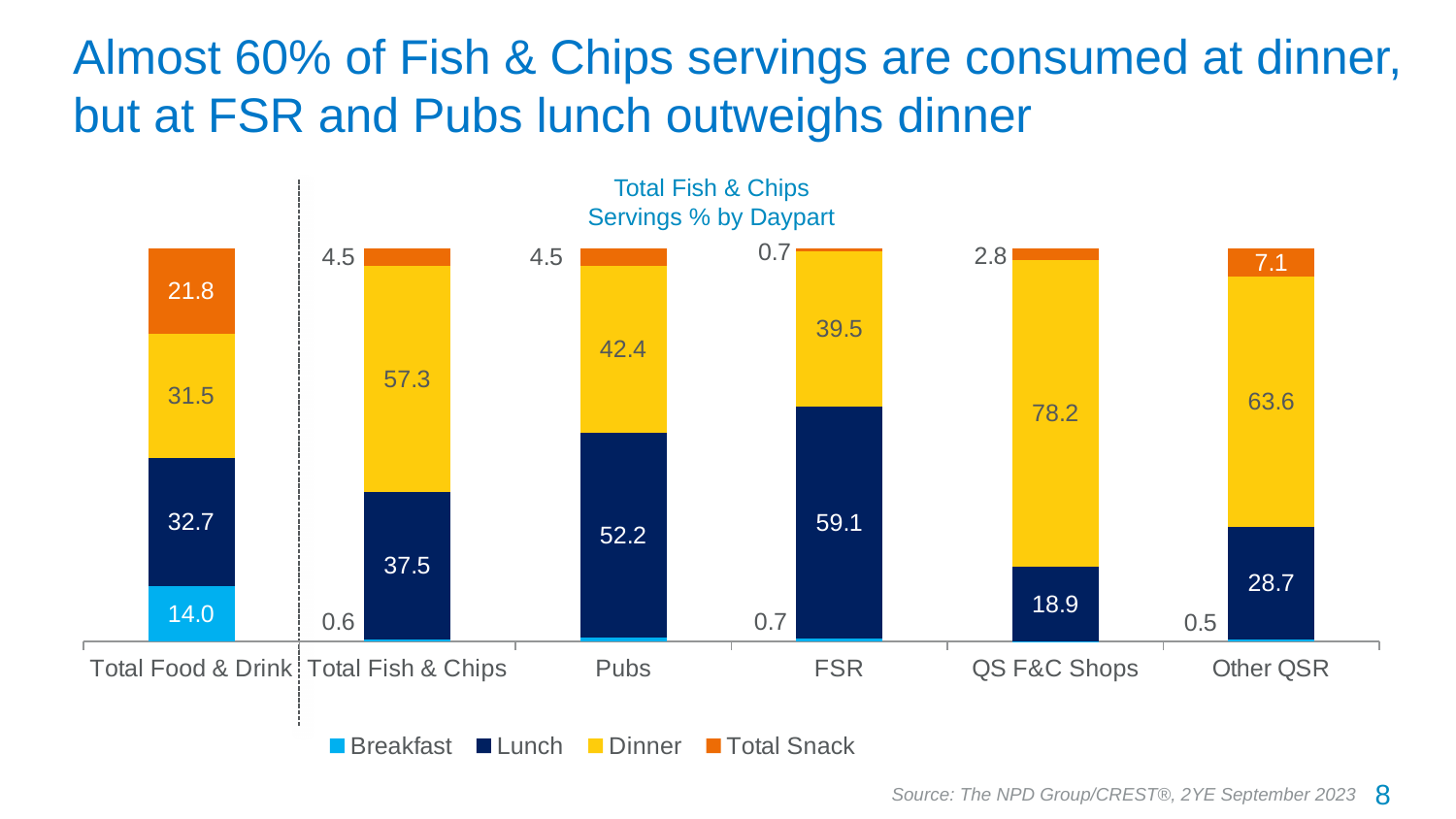
What is the Dinner value for QS F&C Shops? 78.2 Which category has the highest Dinner value? QS F&C Shops How many categories are shown on the x axis? 6 How many series does the legend list? 4 What is the Breakfast value for Total Food & Drink? 14.0 For Pubs, which is larger: the Lunch value or the Dinner value? Lunch For Total Fish & Chips, how much larger is the Dinner value than the Lunch value? 19.8 What is the Total Snack value for Other QSR? 7.1 Which category has the lowest Lunch value? QS F&C Shops What is the total of the stacked bar for Total Food & Drink? 100.0 What is the Lunch value for FSR? 59.1 What kind of chart is shown on the slide? Stacked bar chart